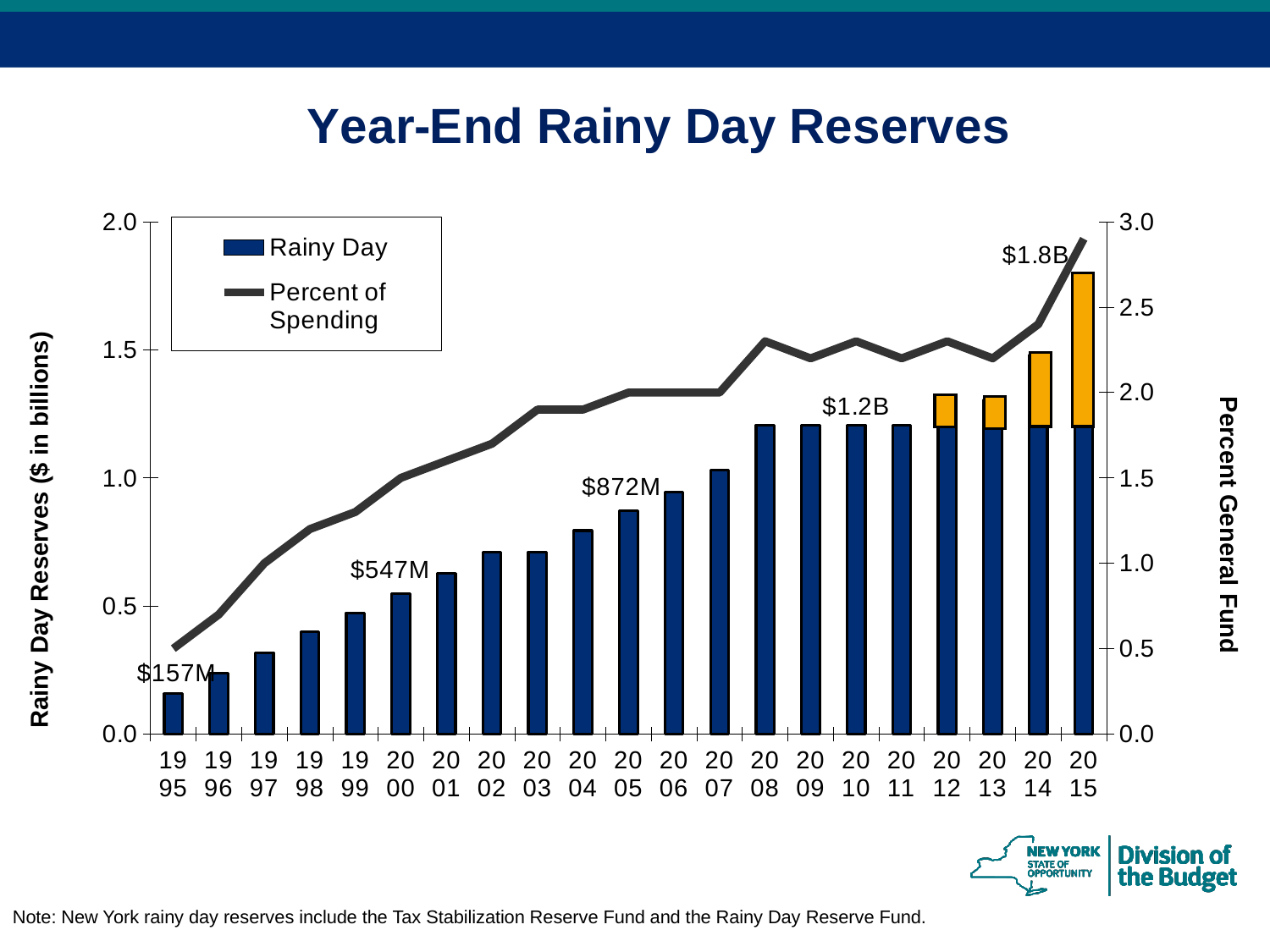
What is the value of the Rainy Day reserves bar for 2000? $547M What is the difference between the Rainy Day reserves for 2005 and 2000? $325M Is the Rainy Day reserves bar for 1998 greater or less than 0.5 billion? less What is the label of the right-hand vertical axis? Percent General Fund Which year has the lowest Rainy Day reserves bar? 1995 What is the value of the Rainy Day reserves bar for 2005? $872M What is the value of the Rainy Day reserves bar for 1995? $157M What is the value of the Rainy Day reserves bar for 2015? $1.8B Which year has the highest Rainy Day reserves bar? 2015 How many years are shown on the x axis? 21 How many series does the legend list? 2 Is the Rainy Day reserves bar for 2012 greater or less than 1.0 billion? greater